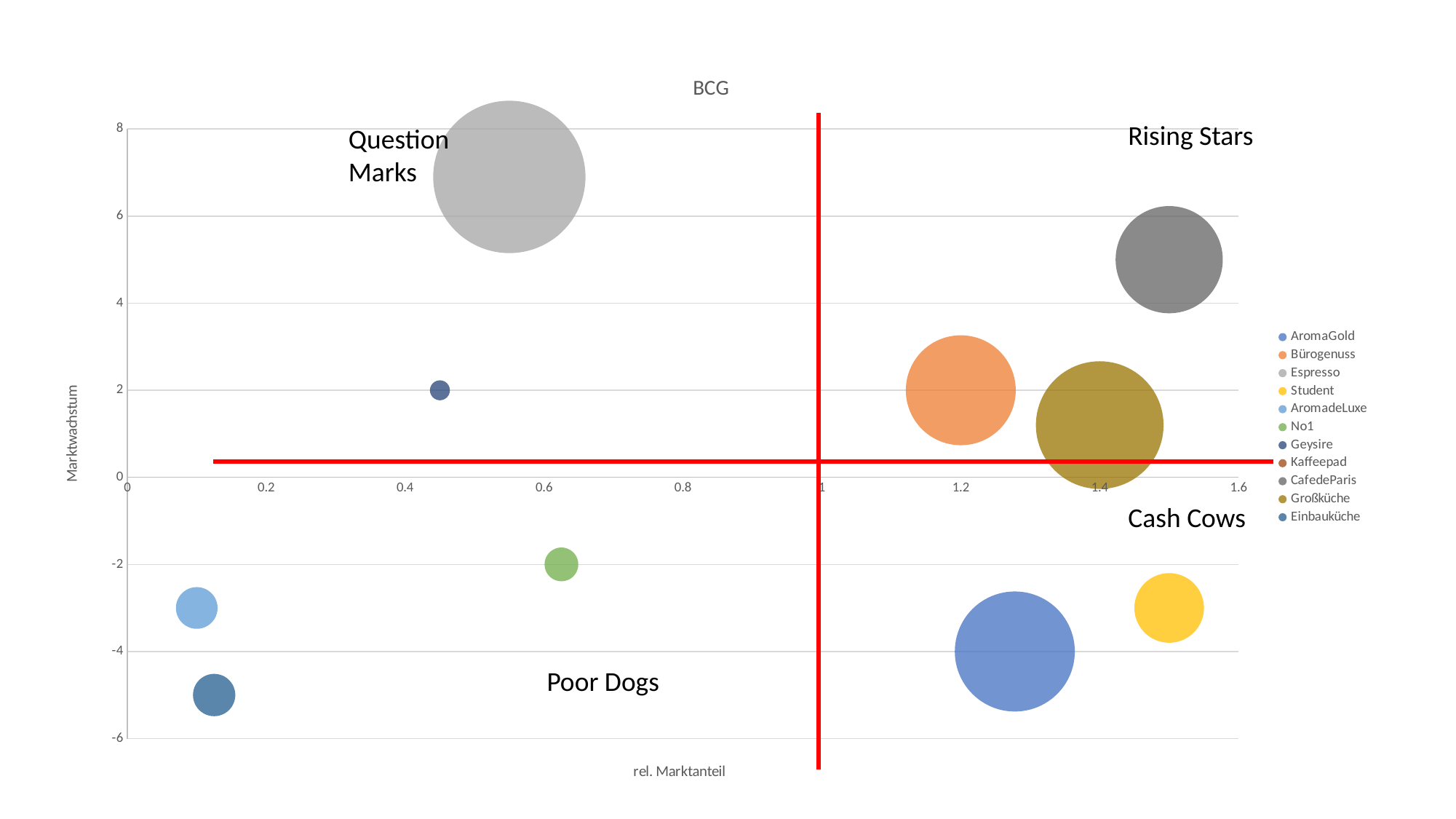
Is the rel. Marktanteil value for CafedeParis greater or less than 1.4? greater Which series has the highest Marktwachstum? Espresso What is the title of the chart? BCG What is the Marktwachstum value for No1? -2 Which has the higher Marktwachstum, Bürogenuss or Großküche? Bürogenuss What kind of chart is shown on the slide? bubble chart What is the Marktwachstum value for AromaGold? -4 How many series does the legend list? 11 Which series has the lowest Marktwachstum? Einbauküche Is the Marktwachstum value for Espresso greater or less than 6? greater What is the Marktwachstum value for Bürogenuss? 2 What is the rel. Marktanteil value for Bürogenuss? 1.2